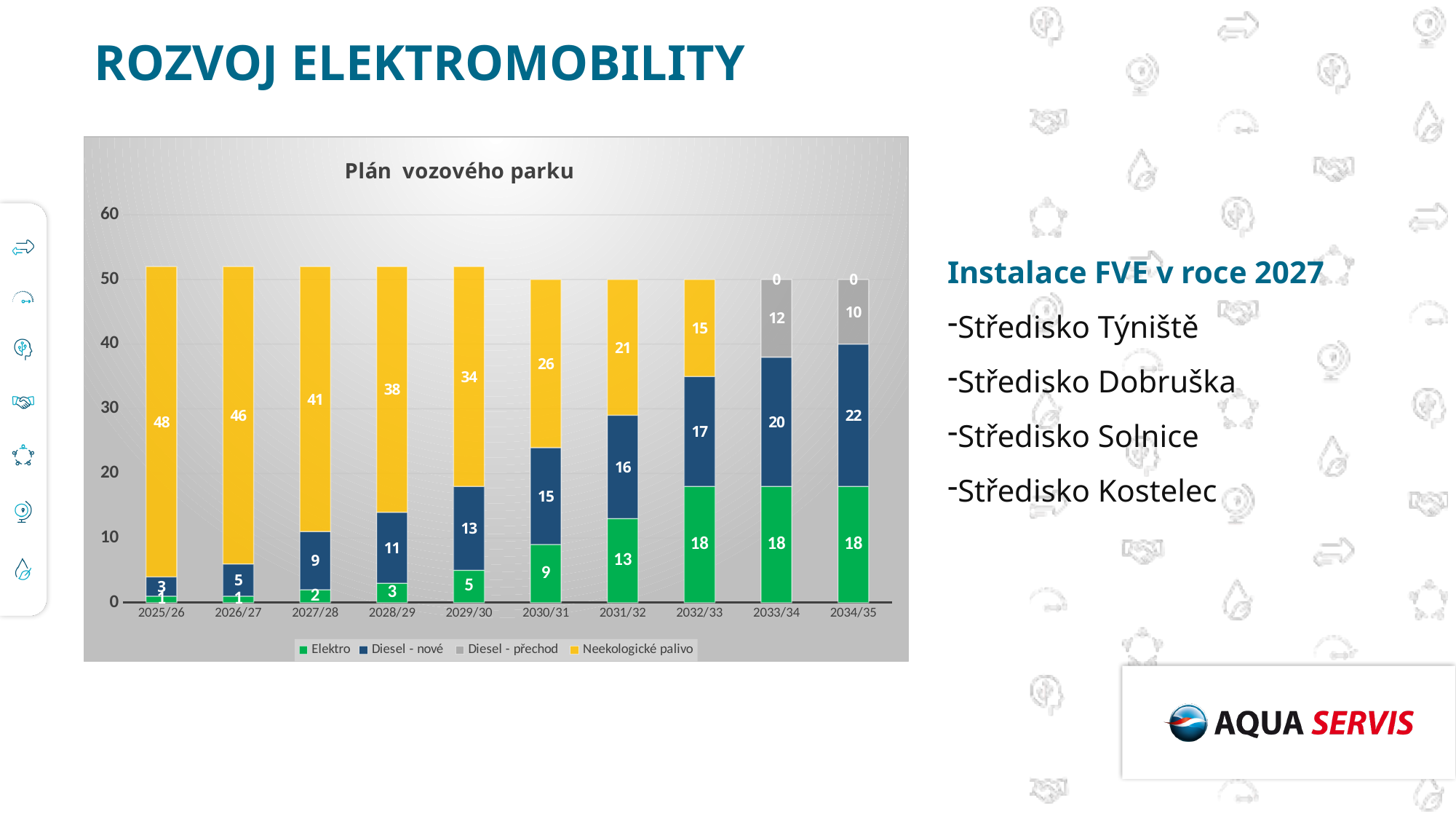
What is the value of Diesel - přechod for 2033/34? 12 Which year has the highest value for Neekologické palivo? 2025/26 How many series does the chart legend list? 4 What kind of chart is shown on the slide? stacked bar chart What is the title of the chart? Plán vozového parku How many year categories are shown on the x axis? 10 What is the value of Neekologické palivo for 2025/26? 48 Which year has the lowest value for Diesel - nové? 2025/26 Which is larger, the Diesel - nové value for 2031/32 or the Neekologické palivo value for 2031/32? Neekologické palivo (21) What is the difference between the Elektro values for 2032/33 and 2025/26? 17 What is the total of the stacked bar for 2033/34? 50 What is the value of Diesel - nové for 2034/35? 22